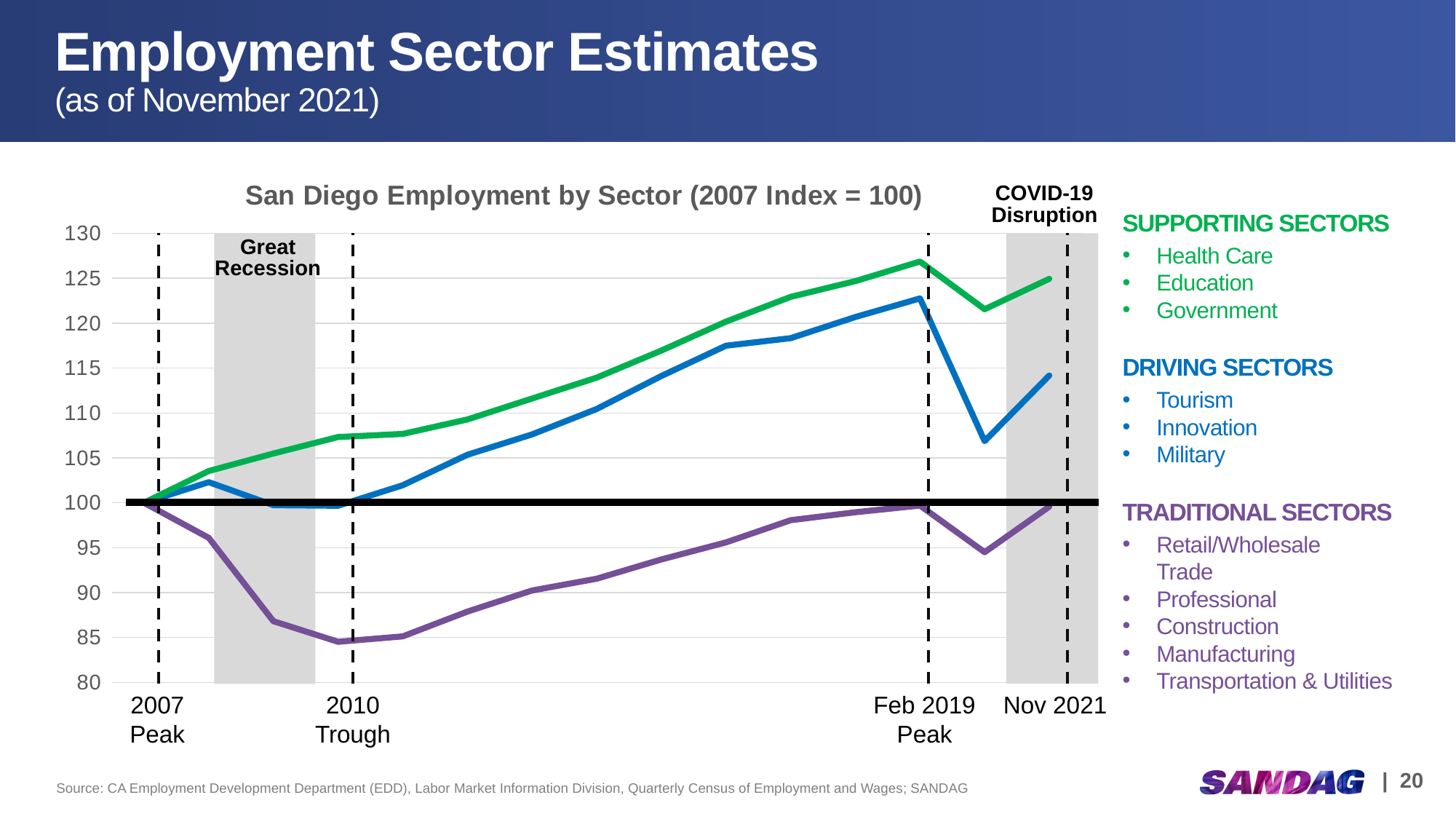
How many sector groups (series) are plotted on the chart? 3 Is the Driving Sectors value at Nov 2021 greater or less than 110? greater What kind of chart is shown on the slide? line chart Between the 2010 Trough and the Feb 2019 Peak, does the Traditional Sectors line rise or fall? rise At Nov 2021, which is larger: the Supporting Sectors value or the Driving Sectors value? Supporting Sectors Which sector group has the highest index value at the Feb 2019 Peak? Supporting Sectors Which sector group has the lowest index value at the 2010 Trough? Traditional Sectors Is the Supporting Sectors value at the Feb 2019 Peak greater or less than 125? greater What event does the shaded region on the right side of the chart represent? COVID-19 Disruption What is the title of the chart? San Diego Employment by Sector (2007 Index = 100) Is the Traditional Sectors value at the 2010 Trough greater or less than 90? less